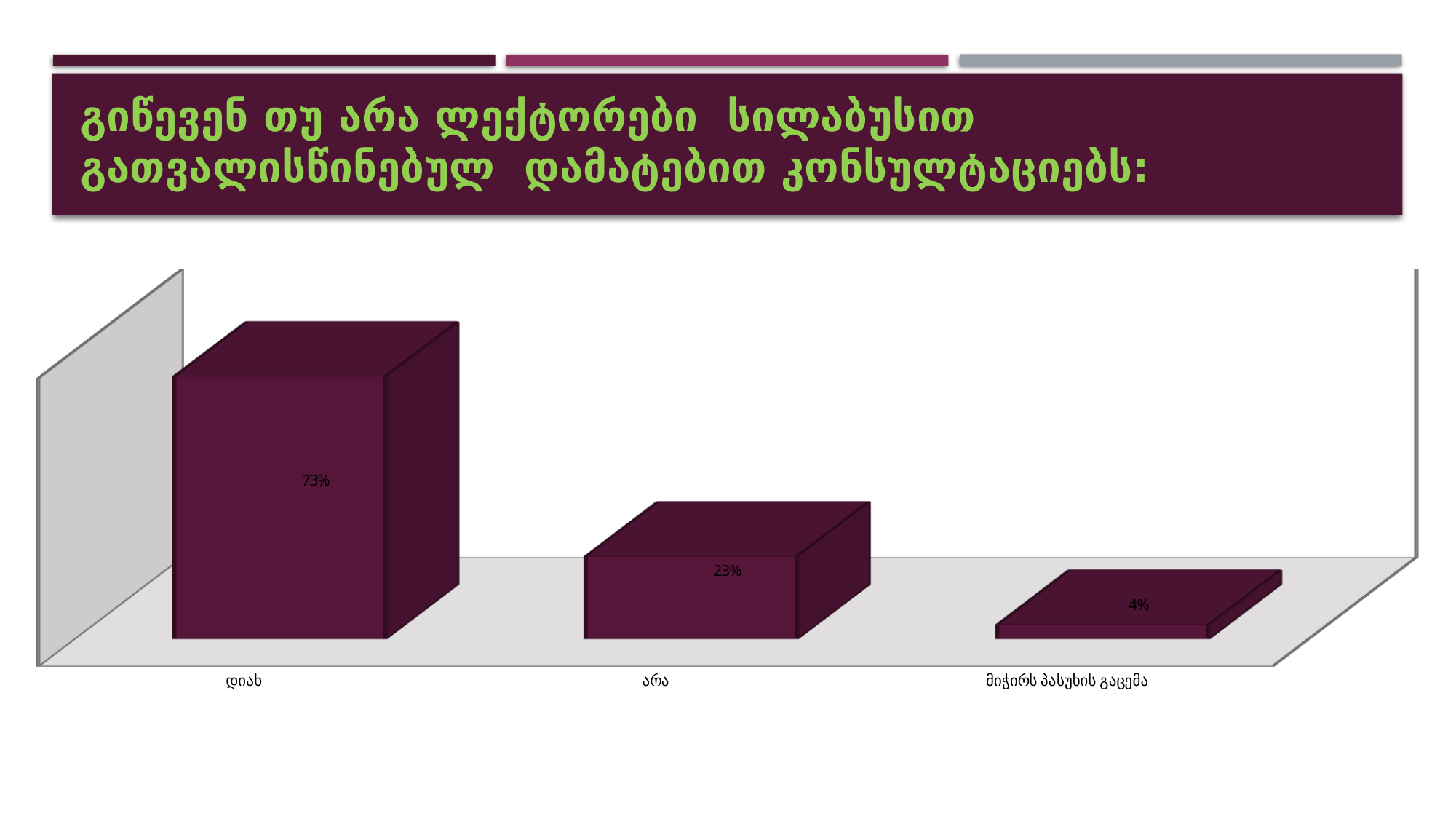
Which category has the lowest value? მიჭირს პასუხის გაცემა What is the value for არა? 23% How many categories are shown in the chart? 3 What kind of chart is shown on the slide? bar chart Which category has the highest value? დიახ What colour are the bars in the chart? dark purple What is the difference between the values for დიახ and არა? 50% What is the value for დიახ? 73% What is the value for მიჭირს პასუხის გაცემა? 4% What is the difference between the values for არა and მიჭირს პასუხის გაცემა? 19% Which is larger, the value for არა or the value for მიჭირს პასუხის გაცემა? არა Do the values rise or fall from left to right across the categories? fall